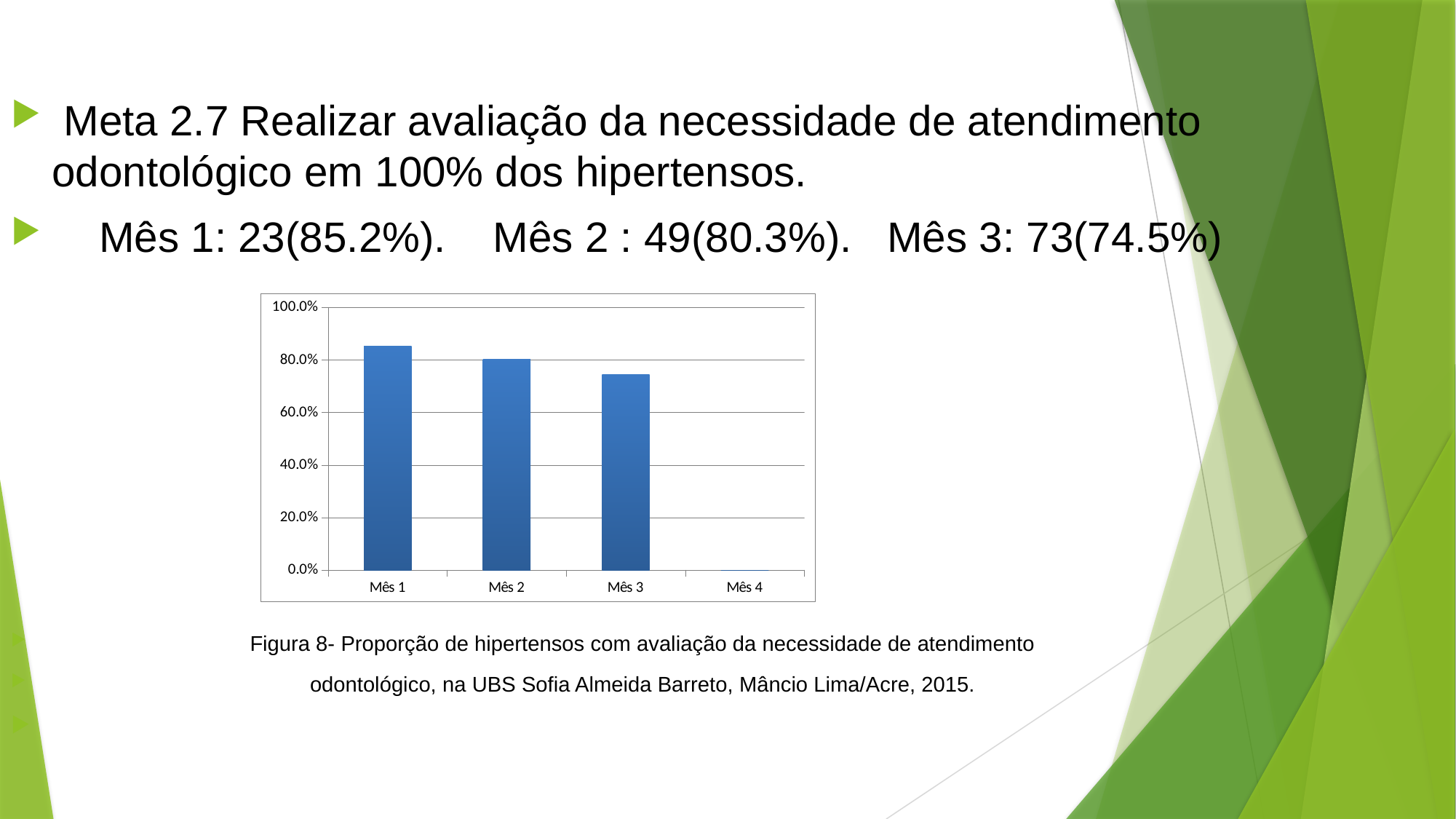
Is the value for Mês 1 greater or less than 80.0%? greater Which is larger, the value for Mês 2 or the value for Mês 3? Mês 2 Among the months with a plotted bar, which has the lowest value? Mês 3 What type of chart is shown on the slide? bar chart What is the value for Mês 1 in the chart? 85.2% Is the value for Mês 3 greater or less than 80.0%? less What is the value for Mês 2 in the chart? 80.3% What is the difference between the values for Mês 1 and Mês 3? 10.7 percentage points How many categories are shown on the x axis of the chart? 4 Which month has the highest bar in the chart? Mês 1 What is the value for Mês 3 in the chart? 74.5% Do the values rise or fall from Mês 1 to Mês 3? fall